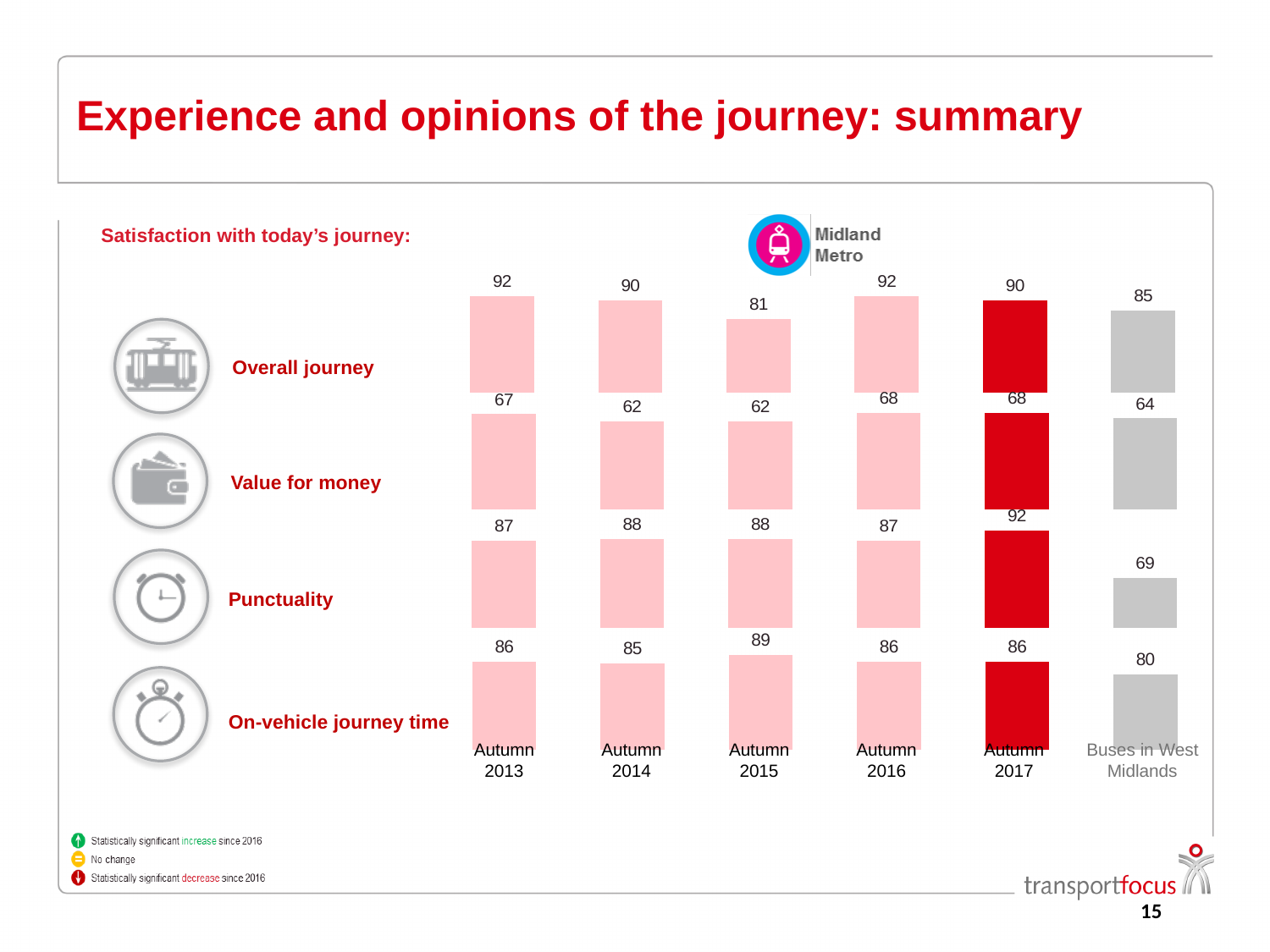
How many categories are shown along the x axis of the On-vehicle journey time chart? 6 In the Value for money chart, what is the value for Autumn 2017? 68 What kind of chart is used for the Overall journey row? Bar chart In the Punctuality chart, what is the difference between the Autumn 2017 value and the Buses in West Midlands value? 23 In the Overall journey chart, what is the value for Autumn 2015? 81 In the On-vehicle journey time chart, what is the value for Buses in West Midlands? 80 In the Punctuality chart, what is the value for Autumn 2017? 92 In the Value for money chart, which is larger: the value for Autumn 2013 or the value for Autumn 2014? Autumn 2013 In the On-vehicle journey time chart, which category has the highest value? Autumn 2015 In the Punctuality chart, which category has the lowest value? Buses in West Midlands In the Overall journey chart, what is the difference between the Autumn 2016 value and the Autumn 2015 value? 11 In the Punctuality chart, what is the value for Buses in West Midlands? 69